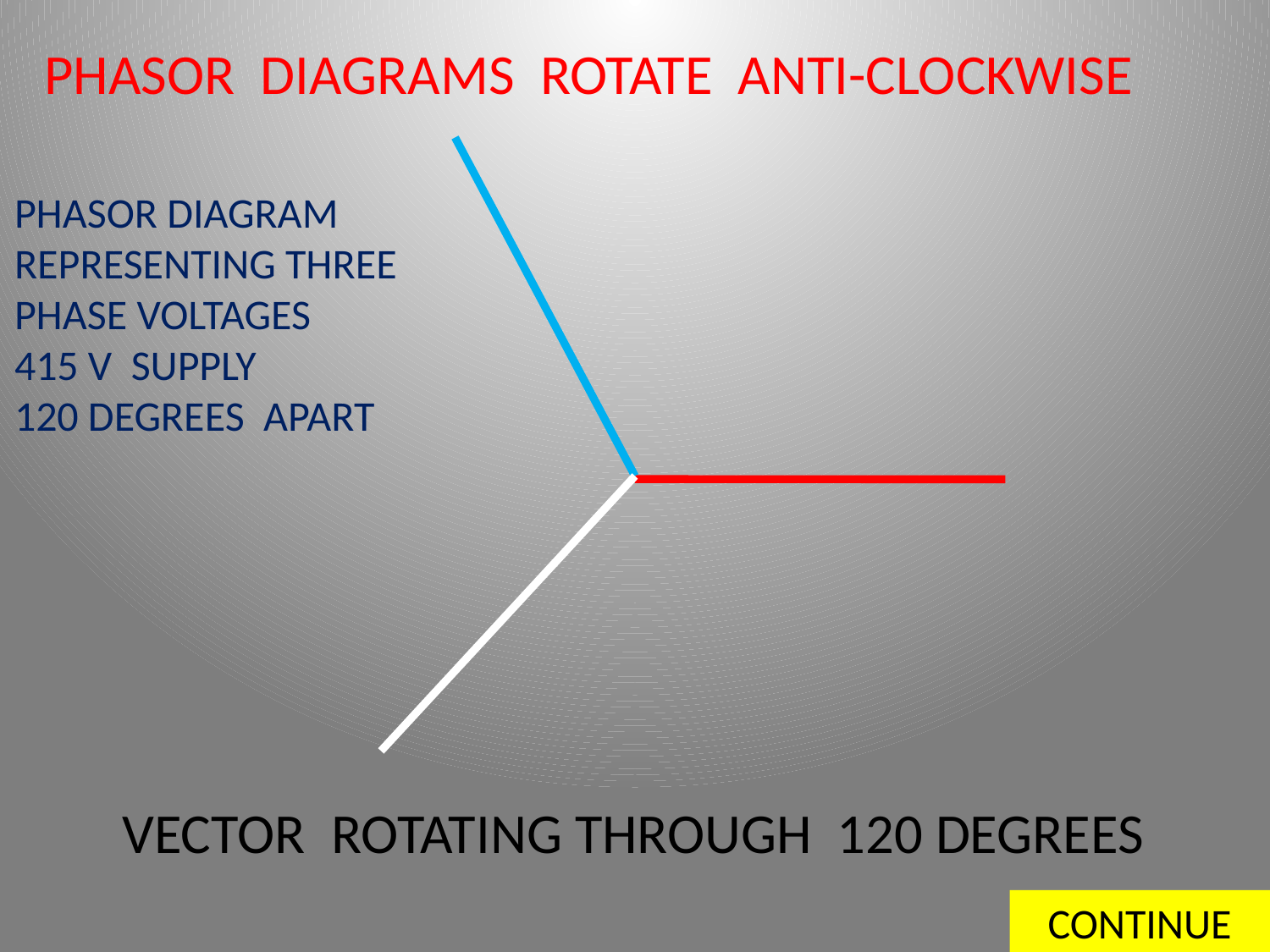
How many phasors (vectors) are drawn in the phasor diagram? 3 What colour is the horizontal phasor pointing to the right in the diagram? Red What supply voltage does the phasor diagram represent, according to the slide text? 415 V What kind of diagram is shown on the slide? Phasor diagram According to the slide text, how many degrees apart are the three phase voltages in the phasor diagram? 120 degrees In which direction does the slide title say phasor diagrams rotate? Anti-clockwise